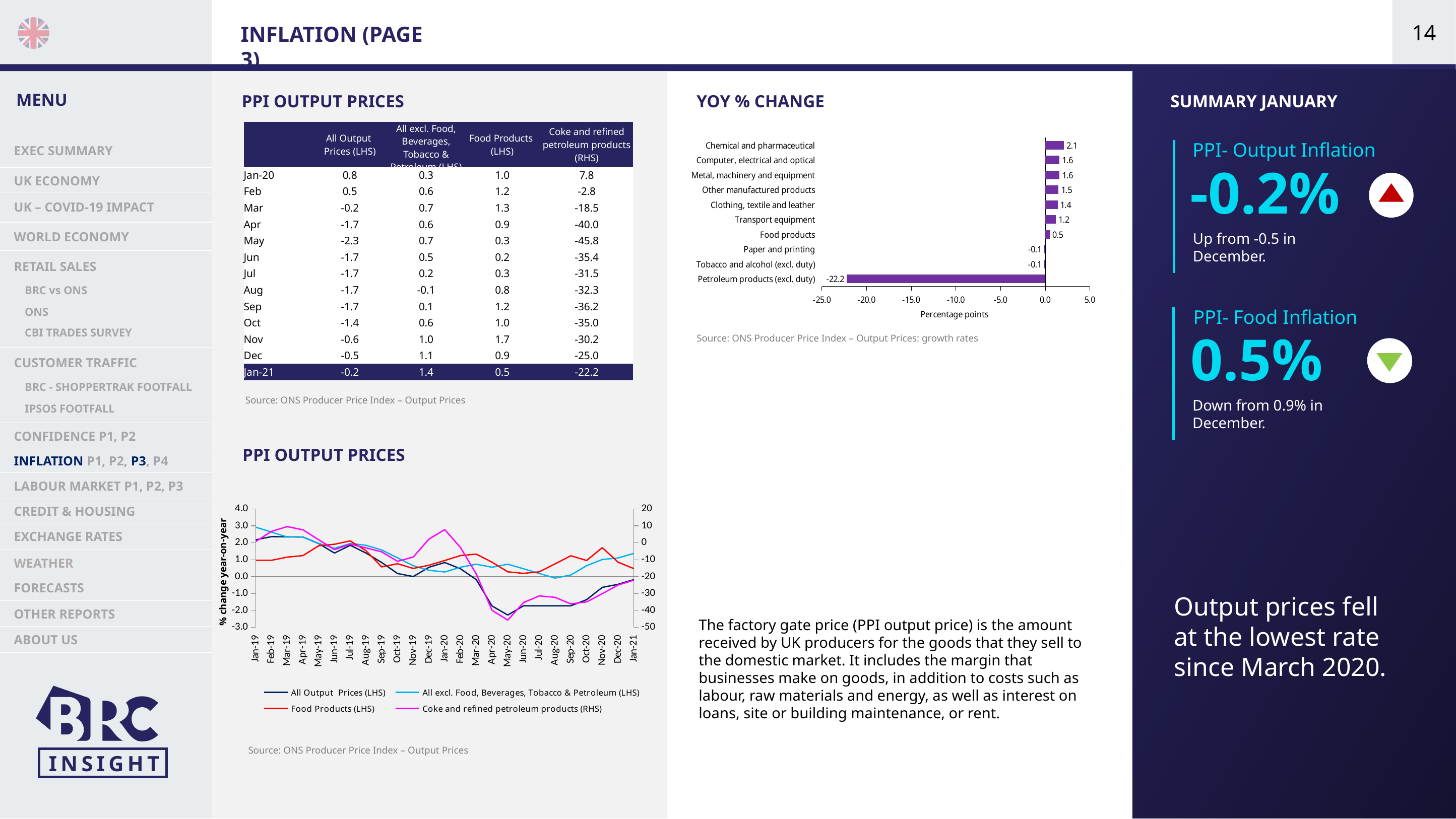
On the YOY % CHANGE chart, which category has the lowest value? Petroleum products (excl. duty) On the PPI OUTPUT PRICES line chart, is the value for Coke and refined petroleum products (RHS) at May-20 greater or less than -40? less How many series does the legend of the PPI OUTPUT PRICES line chart list? 4 On the YOY % CHANGE chart, what is the difference between Chemical and pharmaceutical and Transport equipment? 0.9 On the YOY % CHANGE chart, which is larger: Clothing, textile and leather or Food products? Clothing, textile and leather On the YOY % CHANGE chart, what is the value for Chemical and pharmaceutical? 2.1 On the YOY % CHANGE chart, which category has the highest value? Chemical and pharmaceutical On the YOY % CHANGE chart, what is the value for Food products? 0.5 On the YOY % CHANGE chart, what is the value for Petroleum products (excl. duty)? -22.2 What kind of chart is the YOY % CHANGE chart? Bar chart What is the y-axis label on the left side of the PPI OUTPUT PRICES line chart? % change year-on-year How many categories are shown on the YOY % CHANGE chart? 10